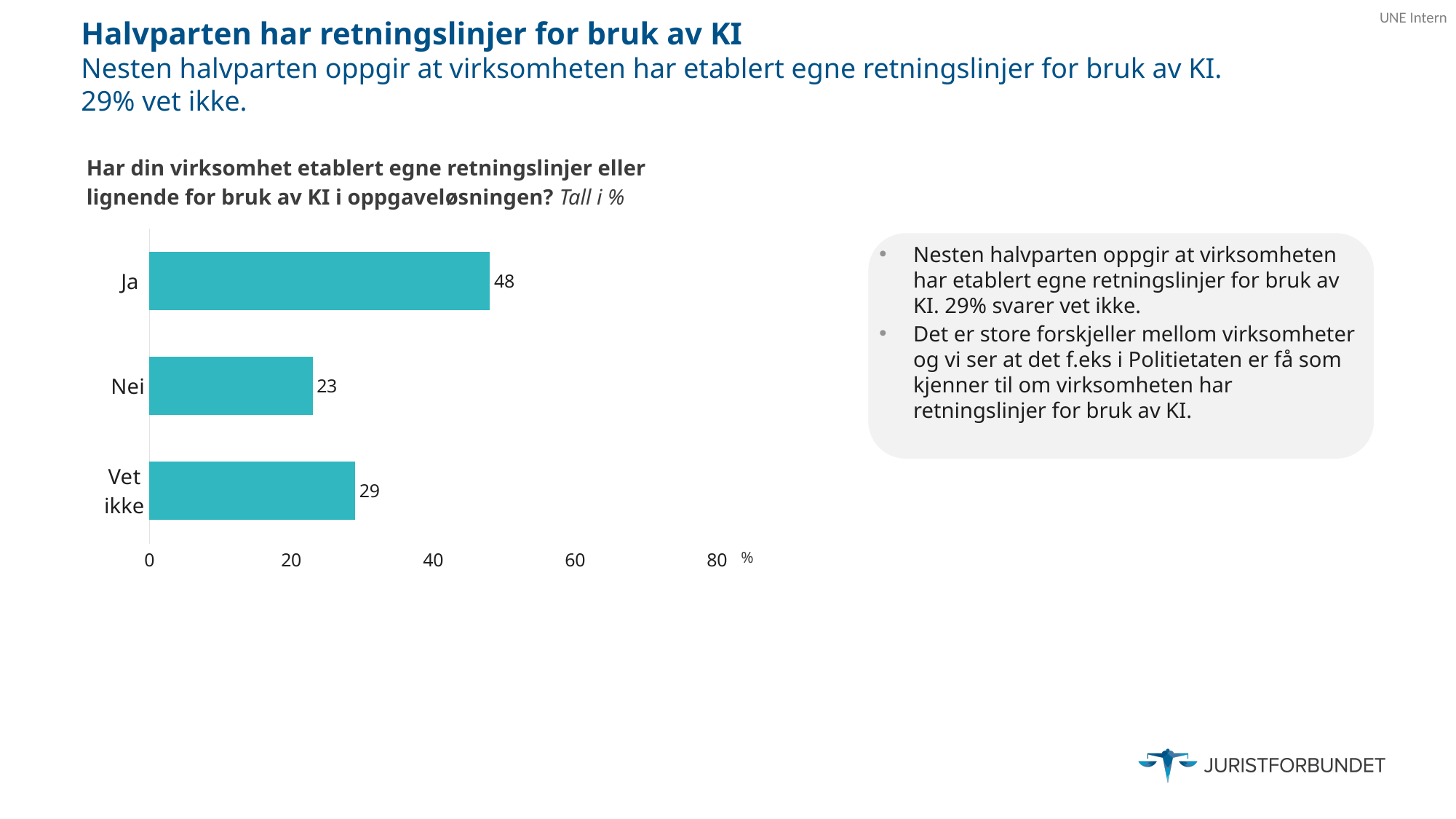
What is the difference between the values for "Vet ikke" and "Nei"? 6 What is the value for "Nei"? 23 Is the value for "Ja" greater or less than 40? greater What unit is indicated at the end of the x axis? % Which category has the lowest value? Nei How many categories are shown in the chart? 3 Which is larger, the value for "Nei" or the value for "Vet ikke"? Vet ikke What is the value for "Vet ikke"? 29 Which category has the highest value? Ja What kind of chart is shown on the slide? bar chart What is the value for "Ja"? 48 What is the difference between the values for "Ja" and "Nei"? 25